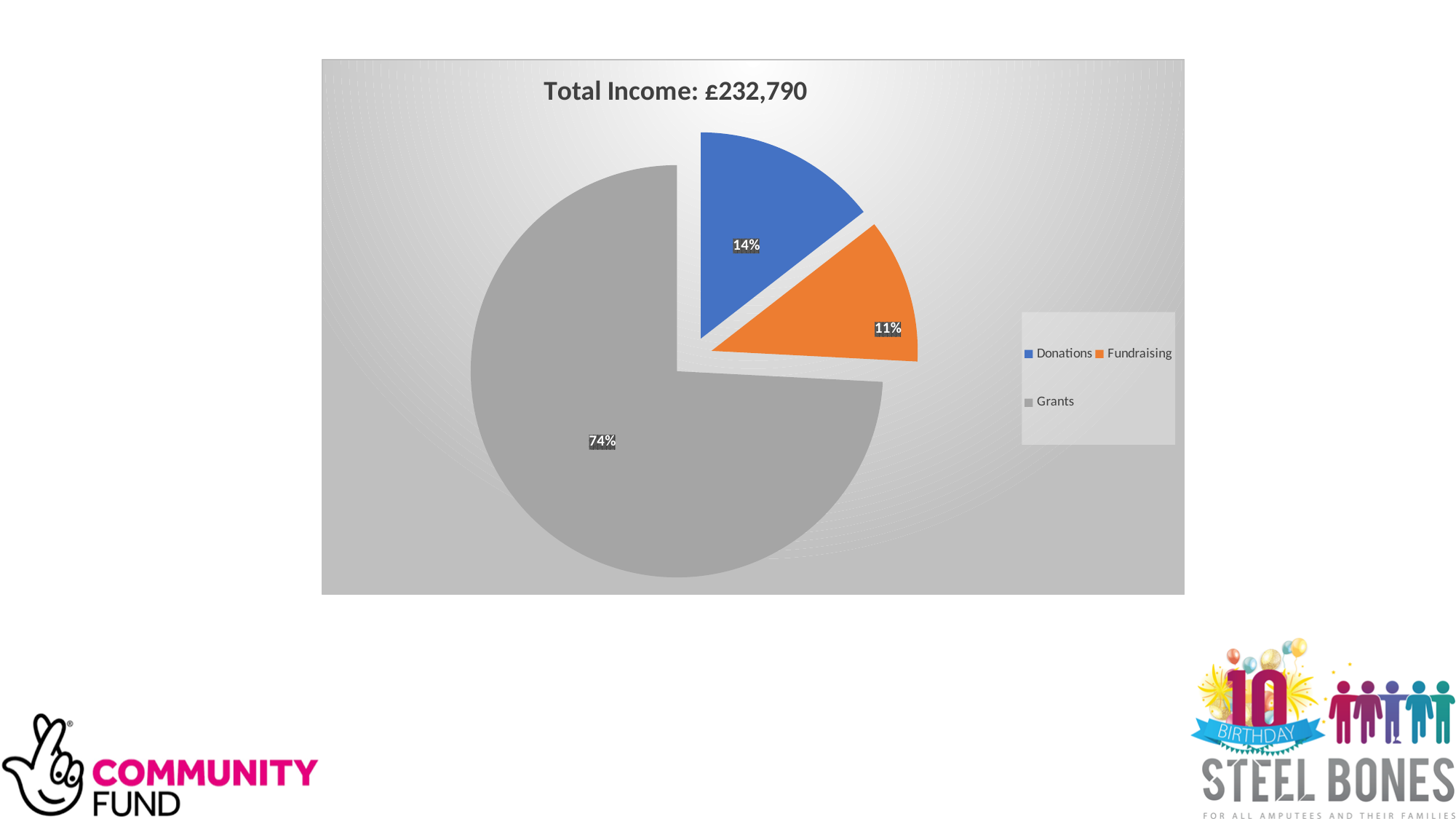
Which is larger, the share for Donations or the share for Fundraising? Donations How many entries does the legend list? 3 How many slices does the pie chart have? 3 What is the difference in percentage points between the Grants share and the Donations share? 60 percentage points Which income source has the smallest share of the pie? Fundraising What share of total income comes from Fundraising? 11% What is the title of the chart? Total Income: £232,790 What colour is the Grants slice? grey What share of total income comes from Grants? 74% What share of total income comes from Donations? 14% What kind of chart is shown on the slide? pie chart Which income source has the largest share of the pie? Grants